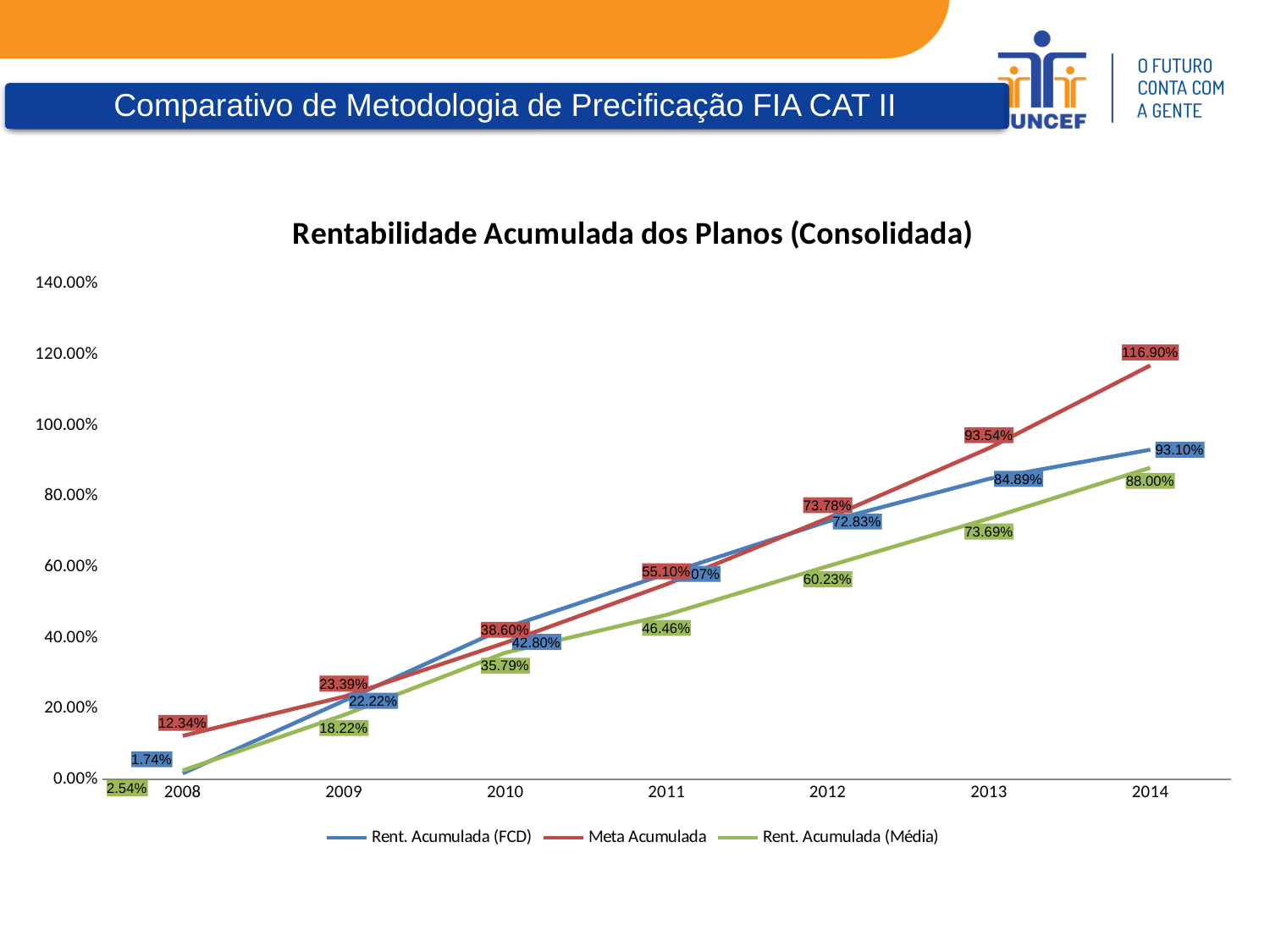
Is the value of Meta Acumulada in 2013 greater or less than 80.00%? greater Which series has the lowest value in 2008? Rent. Acumulada (FCD) How many series does the legend list? 3 What kind of chart is shown on the slide? Line chart What is the value of Meta Acumulada in 2008? 12.34% Which series has the highest value in 2014? Meta Acumulada What is the difference between Meta Acumulada and Rent. Acumulada (Média) in 2014? 28.90% What is the value of Rent. Acumulada (FCD) in 2014? 93.10% What is the value of Rent. Acumulada (Média) in 2012? 60.23% What is the value of Meta Acumulada in 2014? 116.90% How many years are shown on the x axis? 7 In 2010, which is larger: Rent. Acumulada (FCD) or Meta Acumulada? Rent. Acumulada (FCD)